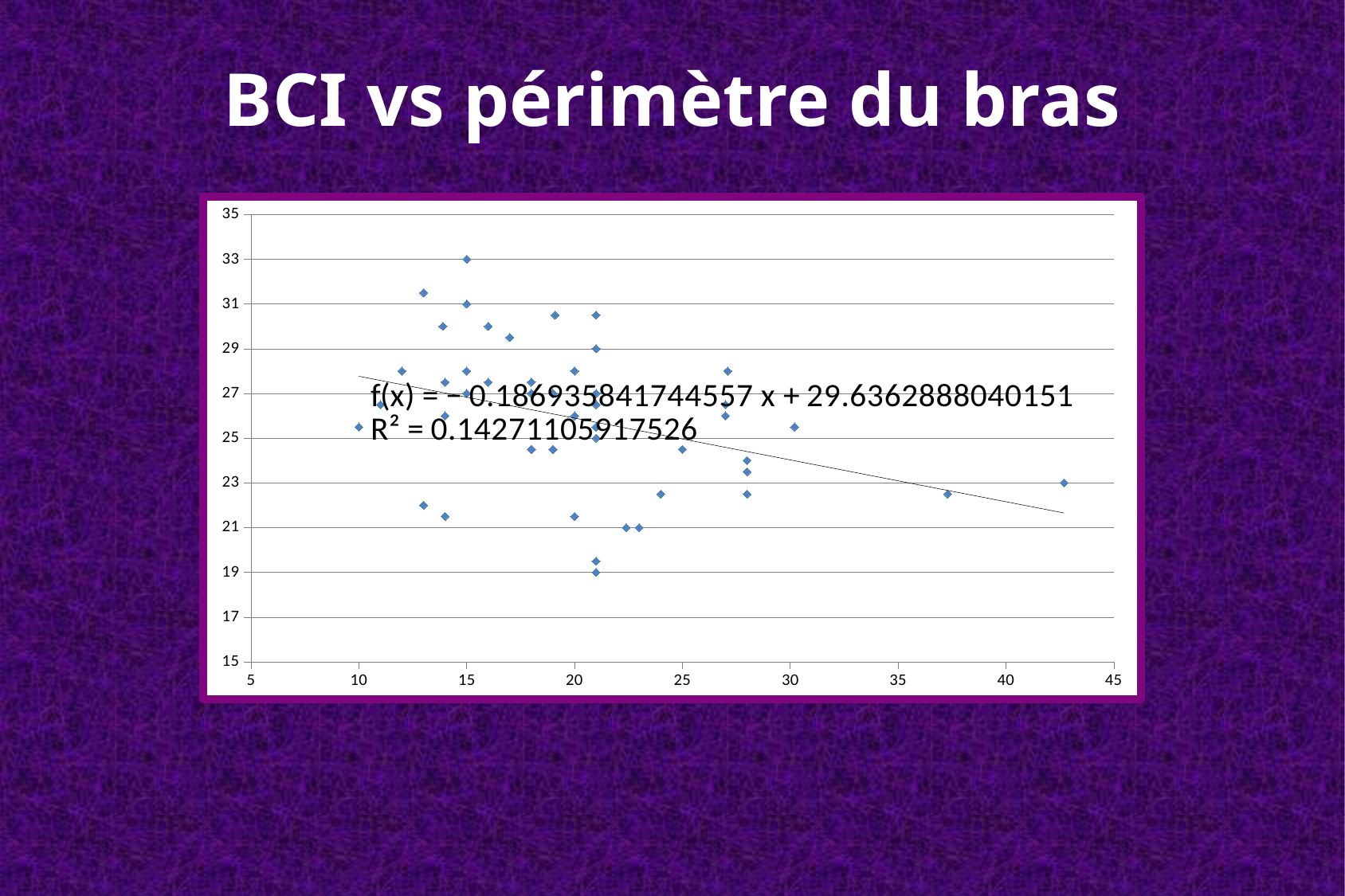
What is the highest y value reached by any point on the chart? 33 Is the slope of the trendline positive or negative? negative Does the fitted trendline on the chart rise or fall as x increases? fall Is the y value of the lowest point on the chart greater or less than 21? less Is the y value of the rightmost point (near x = 43) greater or less than 25? less Is the y value of the point near x = 37 greater or less than 23? less What R² value is printed on the chart? R² = 0.14271105917526 What kind of chart is shown on the slide? scatter chart What is the lowest y value reached by any point on the chart? 19 What is the equation of the trendline printed on the chart? f(x) = −0.186935841744557 x + 29.6362888040151